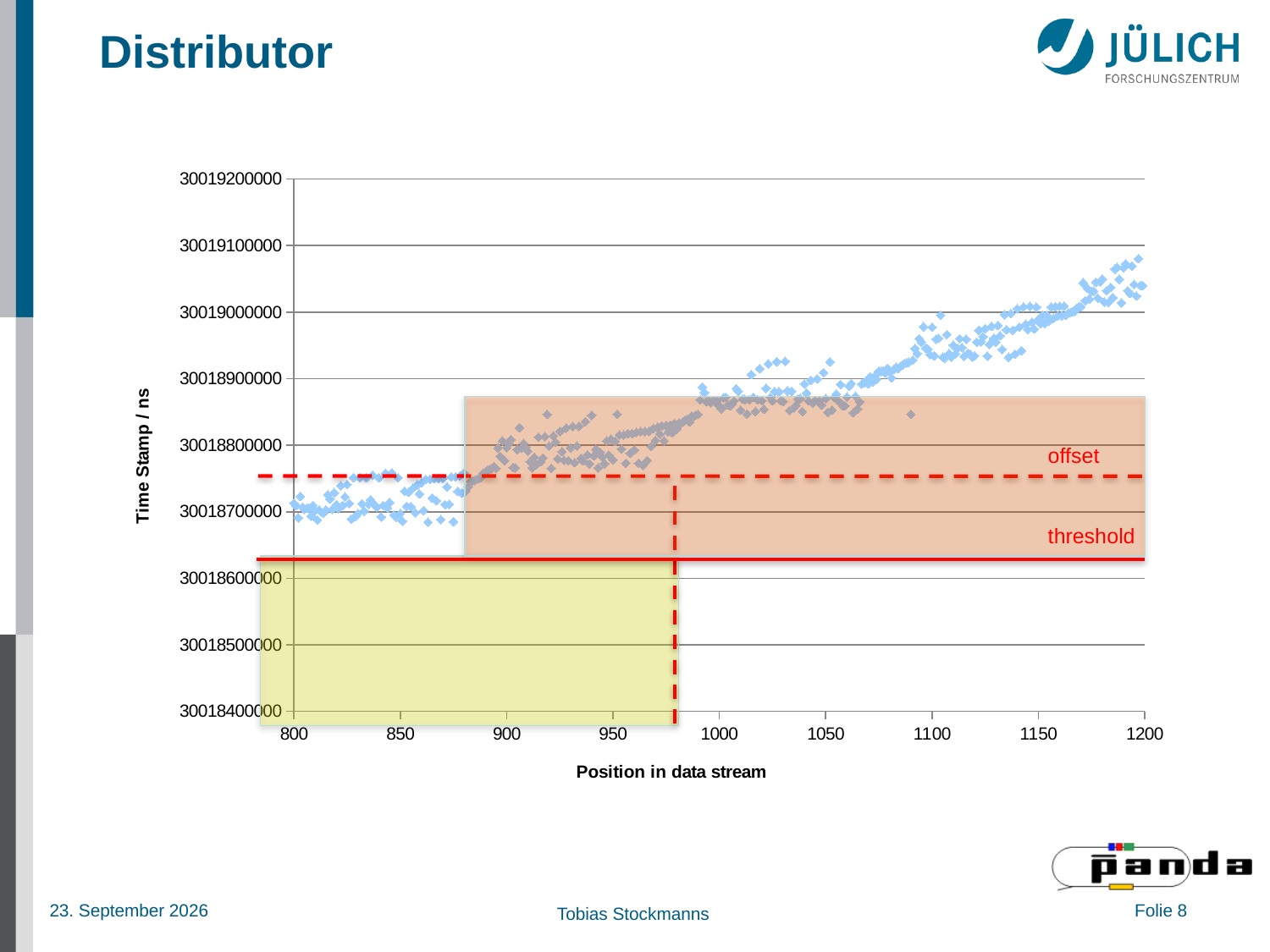
What is the highest value shown on the x axis? 1200 Is the time stamp value at position 1100 greater or less than 30019100000? less What is the lowest value shown on the y axis? 30018400000 What kind of chart is shown on the slide? scatter chart Is the time stamp value at position 1000 greater or less than 30018700000? greater What is the label of the y axis? Time Stamp / ns What is the label of the x axis? Position in data stream Is the time stamp value at position 800 greater or less than 30018800000? less Which has the larger time stamp value: the point at position 800 or the point at position 1200? position 1200 Do the plotted time stamp values rise or fall as the position in the data stream increases from 800 to 1200? rise